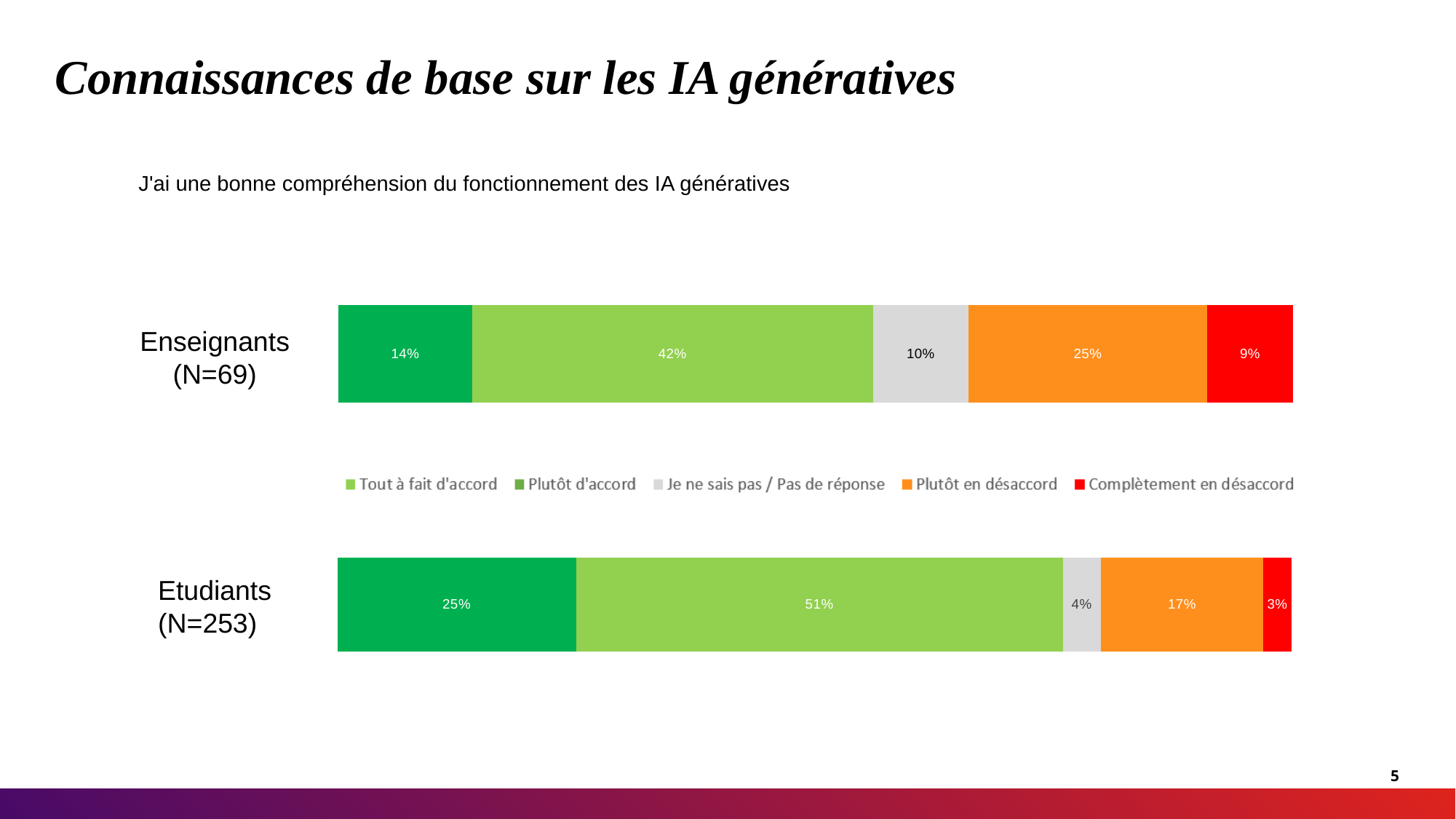
What percentage of Enseignants (N=69) answered "Complètement en désaccord" (red segment)? 9% What is the smallest segment value in the Enseignants (N=69) bar? 9% What percentage of Etudiants (N=253) answered "Plutôt en désaccord" (orange segment)? 17% What percentage of Etudiants (N=253) answered "Complètement en désaccord" (red segment)? 3% Which group has the larger share of "Je ne sais pas / Pas de réponse", Enseignants or Etudiants? Enseignants How many respondent groups (bars) are shown in the chart? 2 What is the total of all segments in the Enseignants (N=69) bar? 100% What percentage of Enseignants (N=69) answered "Je ne sais pas / Pas de réponse" (grey segment)? 10% What is the largest segment value in the Etudiants (N=253) bar? 51% What is the difference in percentage points between Enseignants and Etudiants for "Plutôt en désaccord"? 8 percentage points What kind of chart is shown on the slide? Stacked bar chart How many response categories does the legend list? 5